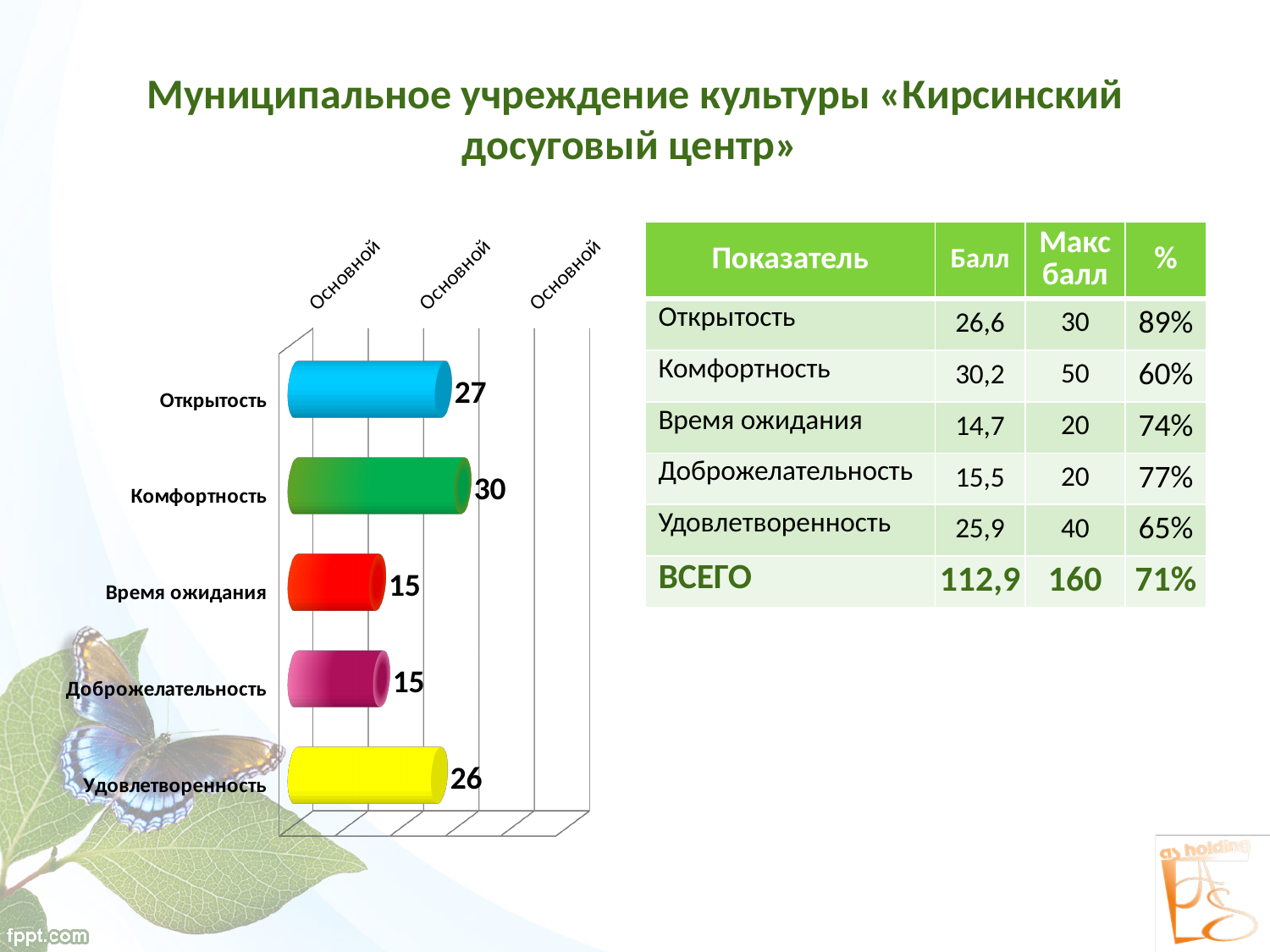
What value does the chart show for Открытость? 27 What colour is the bar for Время ожидания in the chart? Red What is the difference between the values for Открытость and Доброжелательность in the chart? 12 What is the difference between the values for Комфортность and Удовлетворенность in the chart? 4 What value does the chart show for Удовлетворенность? 26 How many categories are shown in the chart? 5 What value does the chart show for Комфортность? 30 Which category has the highest value in the chart? Комфортность What kind of chart is shown on the slide? Bar chart What value does the chart show for Время ожидания? 15 Which is larger in the chart, the value for Открытость or the value for Удовлетворенность? Открытость Which is larger in the chart, the value for Комфортность or the value for Время ожидания? Комфортность